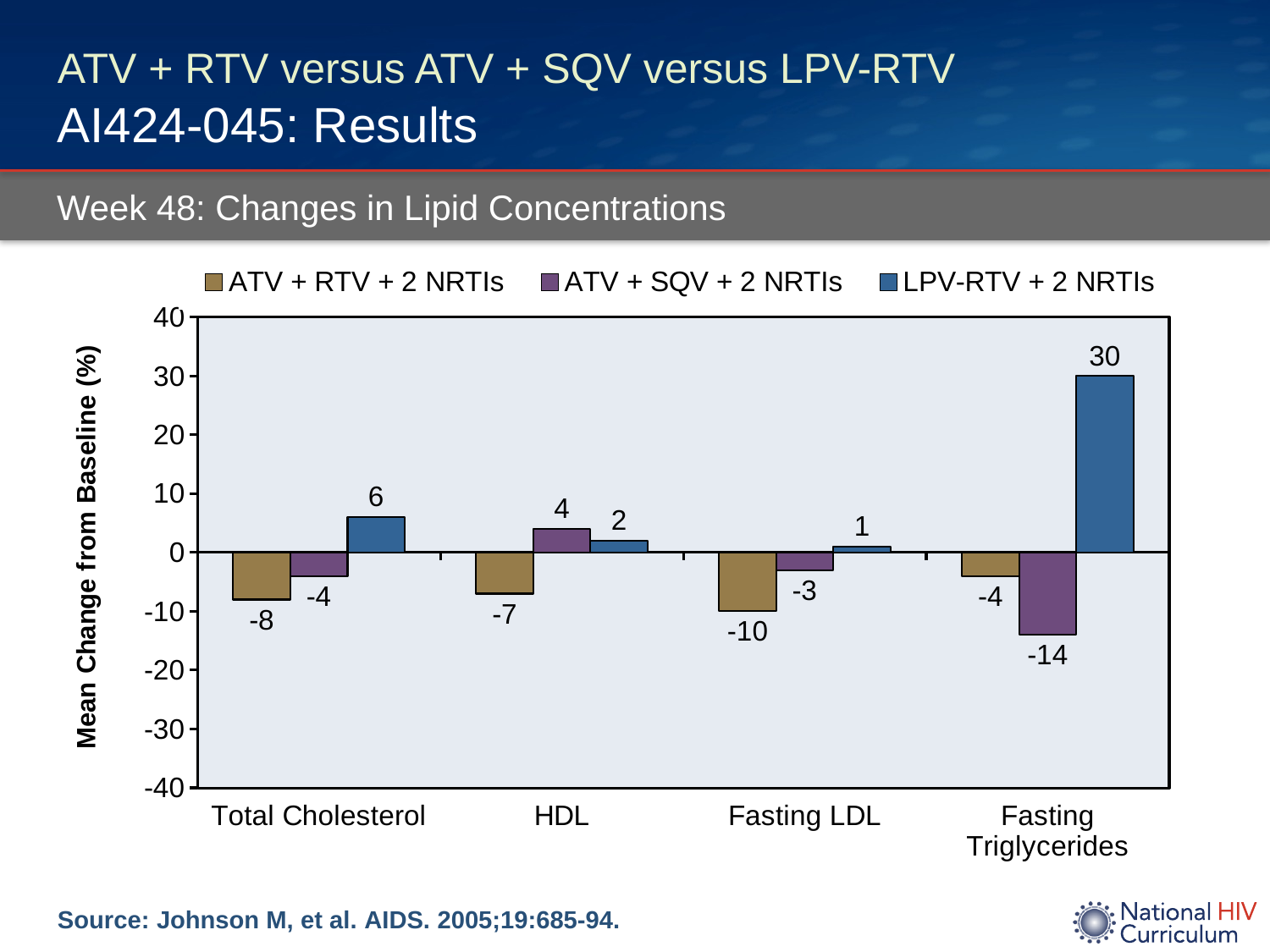
Which lipid category shows the lowest value for the ATV + SQV + 2 NRTIs arm? Fasting Triglycerides What is the mean change from baseline in Fasting LDL for the LPV-RTV + 2 NRTIs arm? 1 How many series does the legend list? 3 What is the mean change from baseline in Total Cholesterol for the ATV + RTV + 2 NRTIs arm? -8 What is the label of the y axis? Mean Change from Baseline (%) What is the mean change from baseline in HDL for the ATV + SQV + 2 NRTIs arm? 4 What is the mean change from baseline in Fasting Triglycerides for the LPV-RTV + 2 NRTIs arm? 30 What is the difference between the LPV-RTV + 2 NRTIs and ATV + RTV + 2 NRTIs values for Fasting Triglycerides? 34 What kind of chart is shown on the slide? Bar chart For Fasting LDL, which arm has the larger mean change from baseline: ATV + RTV + 2 NRTIs or ATV + SQV + 2 NRTIs? ATV + SQV + 2 NRTIs Which lipid category shows the largest increase for the LPV-RTV + 2 NRTIs arm? Fasting Triglycerides How many lipid categories are shown on the x axis? 4